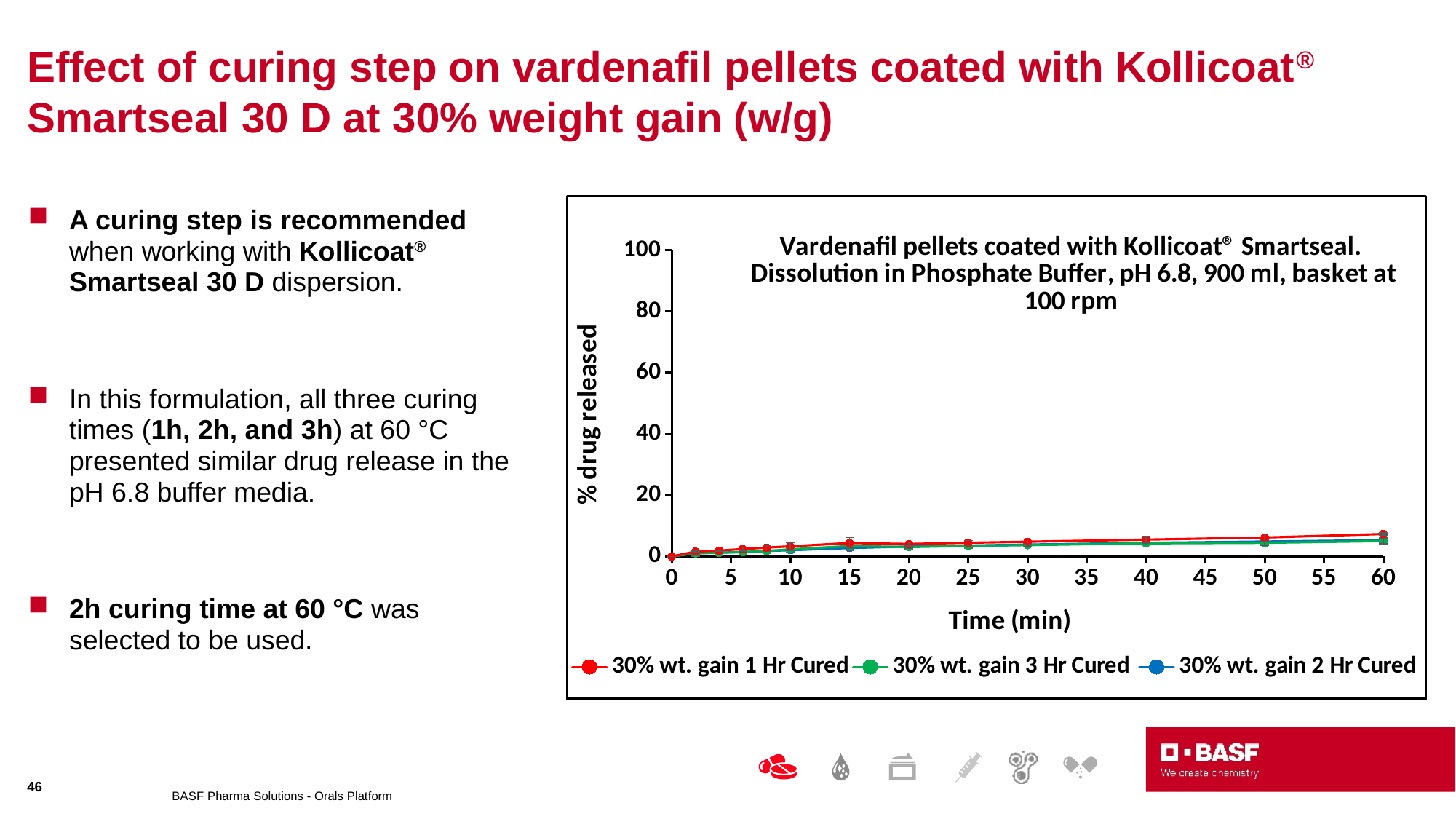
Is the value for 30% wt. gain 2 Hr Cured at 30 min greater or less than 20? less What is the highest value shown on the y axis of the chart? 100 What is the label of the x axis of the chart? Time (min) Is the value for 30% wt. gain 1 Hr Cured at 60 min greater or less than 20? less What kind of chart is shown on the slide? line chart How many series does the chart legend list? 3 Do the values for 30% wt. gain 1 Hr Cured rise or fall as time increases from 0 to 60 min? rise Is the value for 30% wt. gain 3 Hr Cured at 60 min greater or less than 20? less What is the label of the y axis of the chart? % drug released